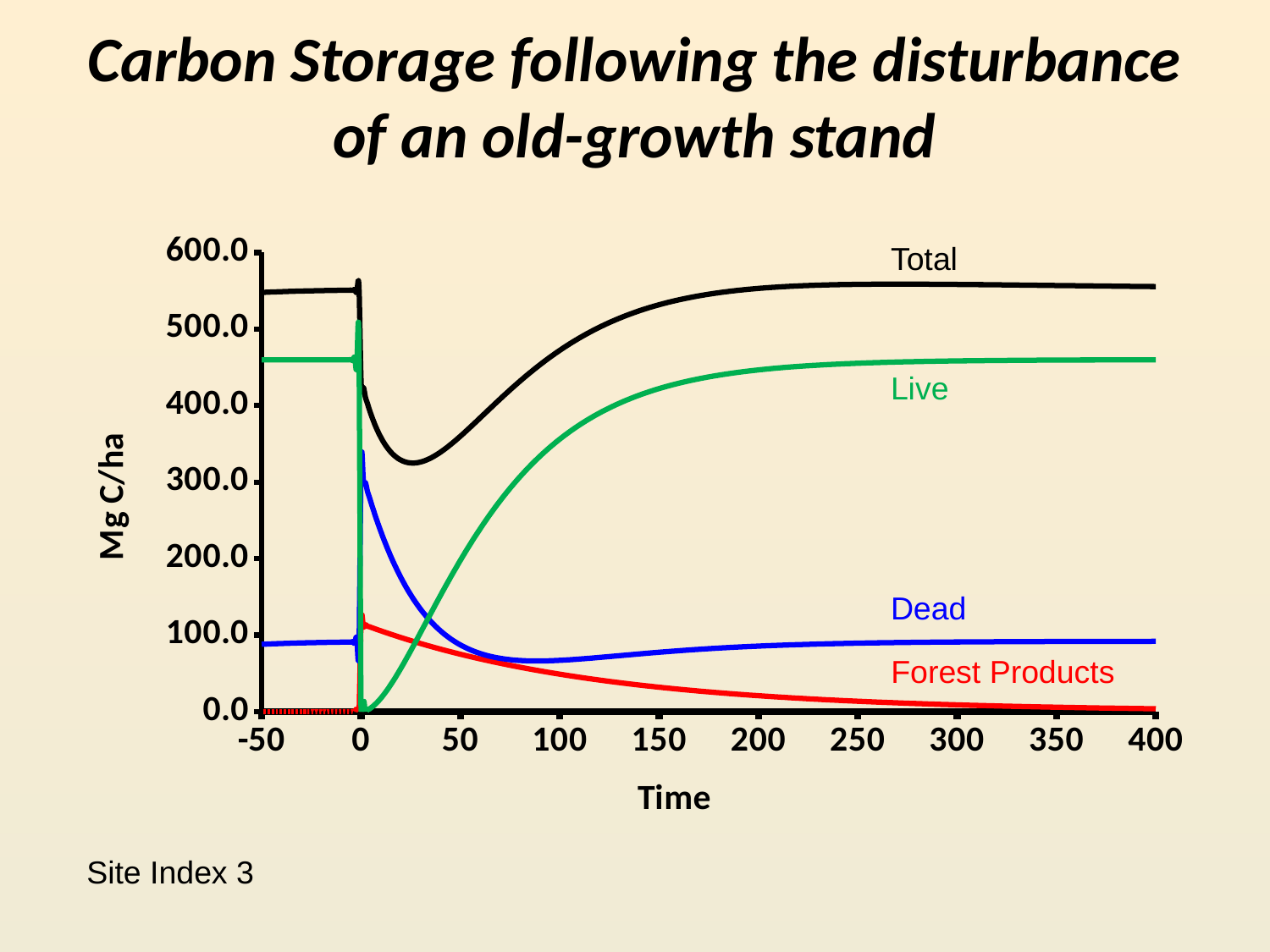
At time 400, which is larger, Live or Dead? Live What is the label of the y axis? Mg C/ha Is the value of Forest Products at time 400 greater or less than 100? less Does the Forest Products series rise or fall between time 0 and time 400? fall Does the Live series rise or fall between time 0 and time 200? rise Is the value of Total at time 400 greater or less than 500? greater Is the lowest value of Total after the disturbance greater or less than 400? less What kind of chart is shown on the slide? line chart Which series has the lowest value at time 400? Forest Products Which series has the highest value at time 400? Total How many series are labelled on the chart? 4